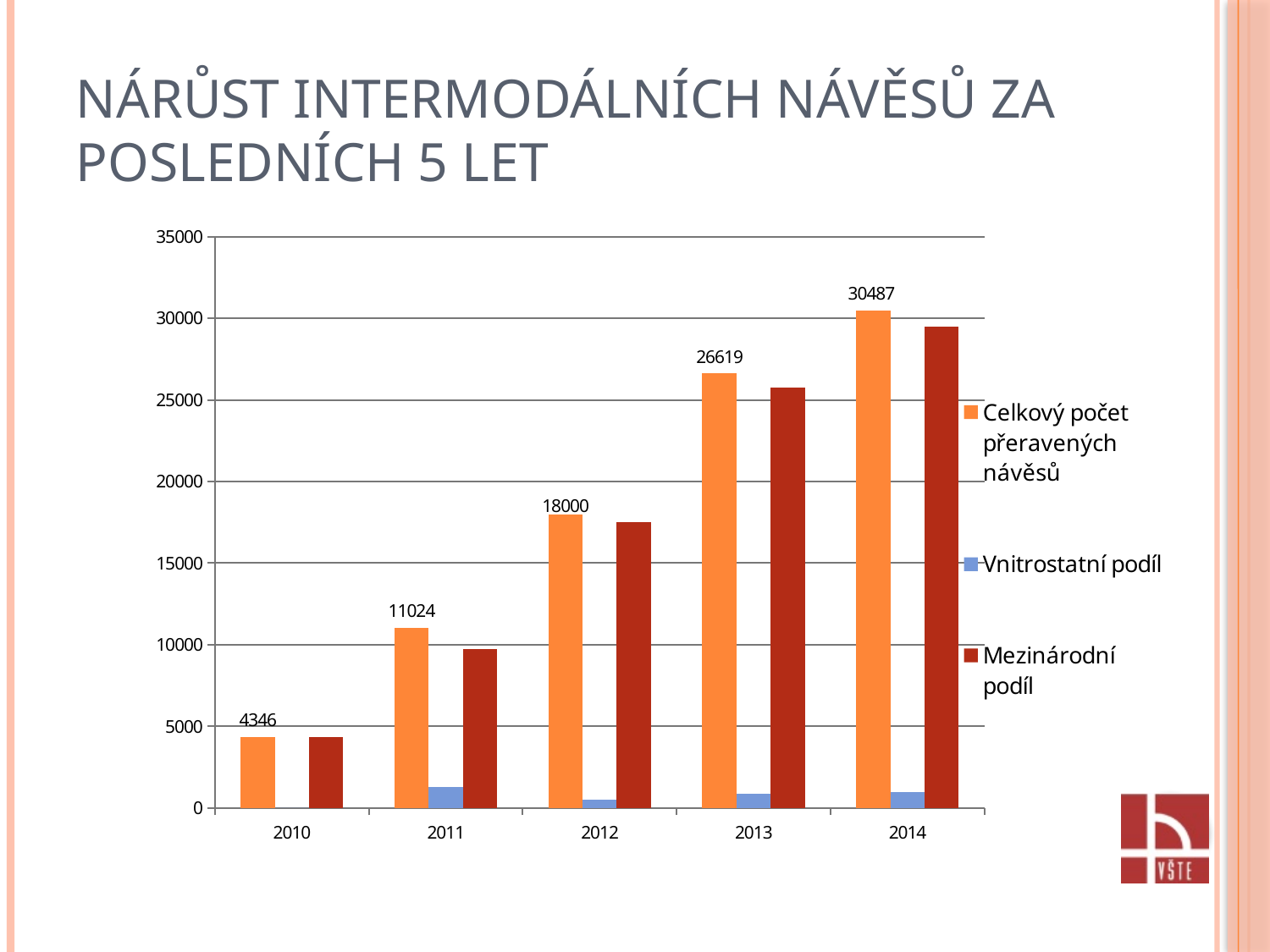
What is the difference between the 'Celkový počet přeravených návěsů' values for 2013 and 2012? 8619 What is the value of 'Celkový počet přeravených návěsů' for 2014? 30487 Which is larger: 'Celkový počet přeravených návěsů' in 2011 or in 2012? 2012 What is the value of 'Celkový počet přeravených návěsů' for 2012? 18000 Which year has the lowest value for 'Celkový počet přeravených návěsů'? 2010 How many series does the legend list? 3 Is the value of 'Vnitrostatní podíl' for 2011 greater or less than 5000? less Is the value of 'Mezinárodní podíl' for 2013 greater or less than 25000? greater Which year has the highest value for 'Celkový počet přeravených návěsů'? 2014 What is the value of 'Celkový počet přeravených návěsů' for 2010? 4346 Does the 'Celkový počet přeravených návěsů' series rise or fall from 2010 to 2014? rise How many years are shown on the x axis? 5